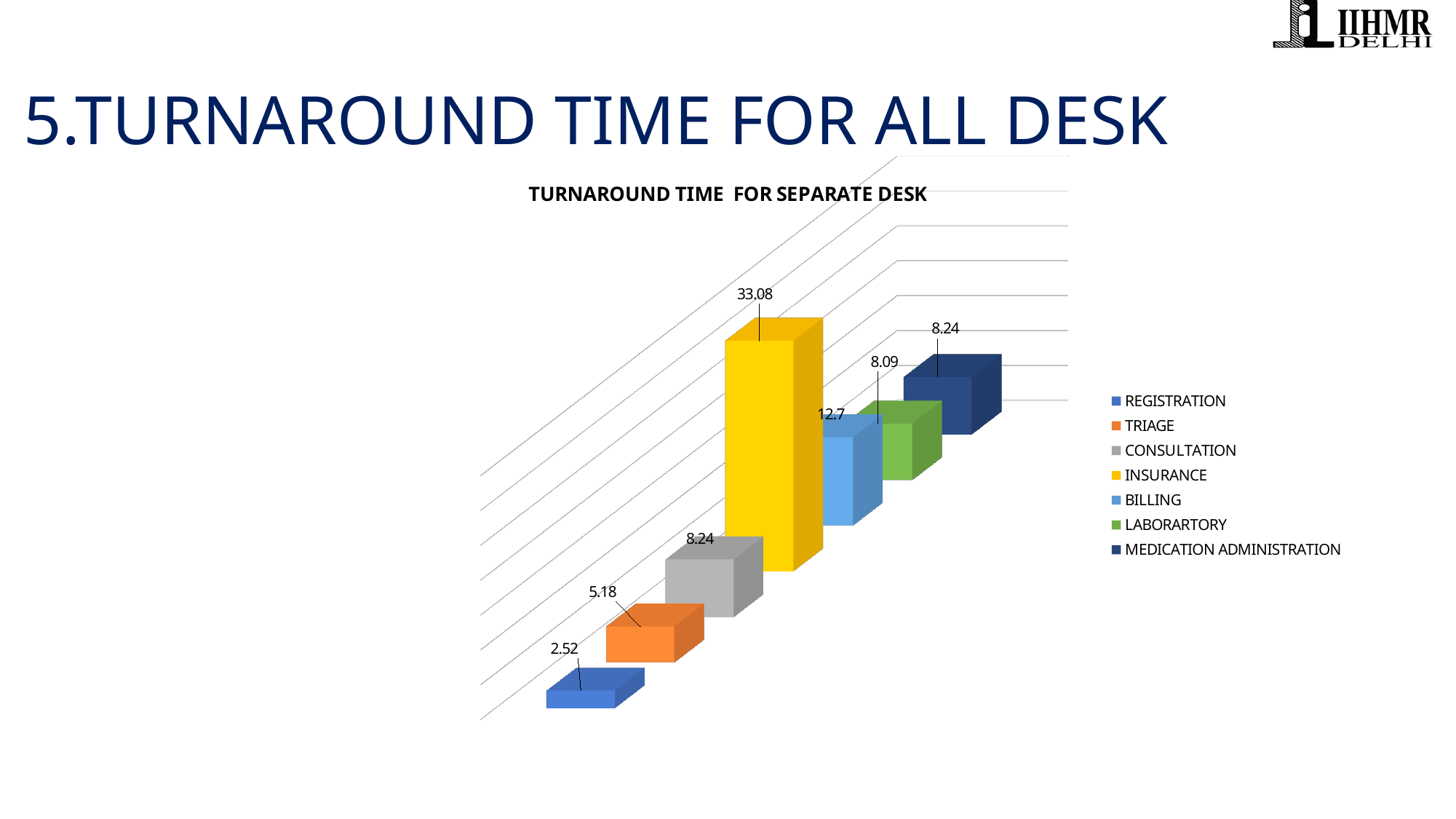
Which desk has the highest turnaround time? INSURANCE What is the title of the chart? TURNAROUND TIME FOR SEPARATE DESK What is the value shown for LABORARTORY? 8.09 What is the turnaround time value shown for INSURANCE? 33.08 What kind of chart is shown on the slide? Bar chart Which has a larger value, BILLING or LABORARTORY? BILLING What is the difference between the values for INSURANCE and BILLING? 20.38 What is the difference between the values for TRIAGE and REGISTRATION? 2.66 Which desk has the lowest turnaround time? REGISTRATION How many desks are plotted in the chart? 7 What is the value shown for REGISTRATION? 2.52 What is the value shown for BILLING? 12.7